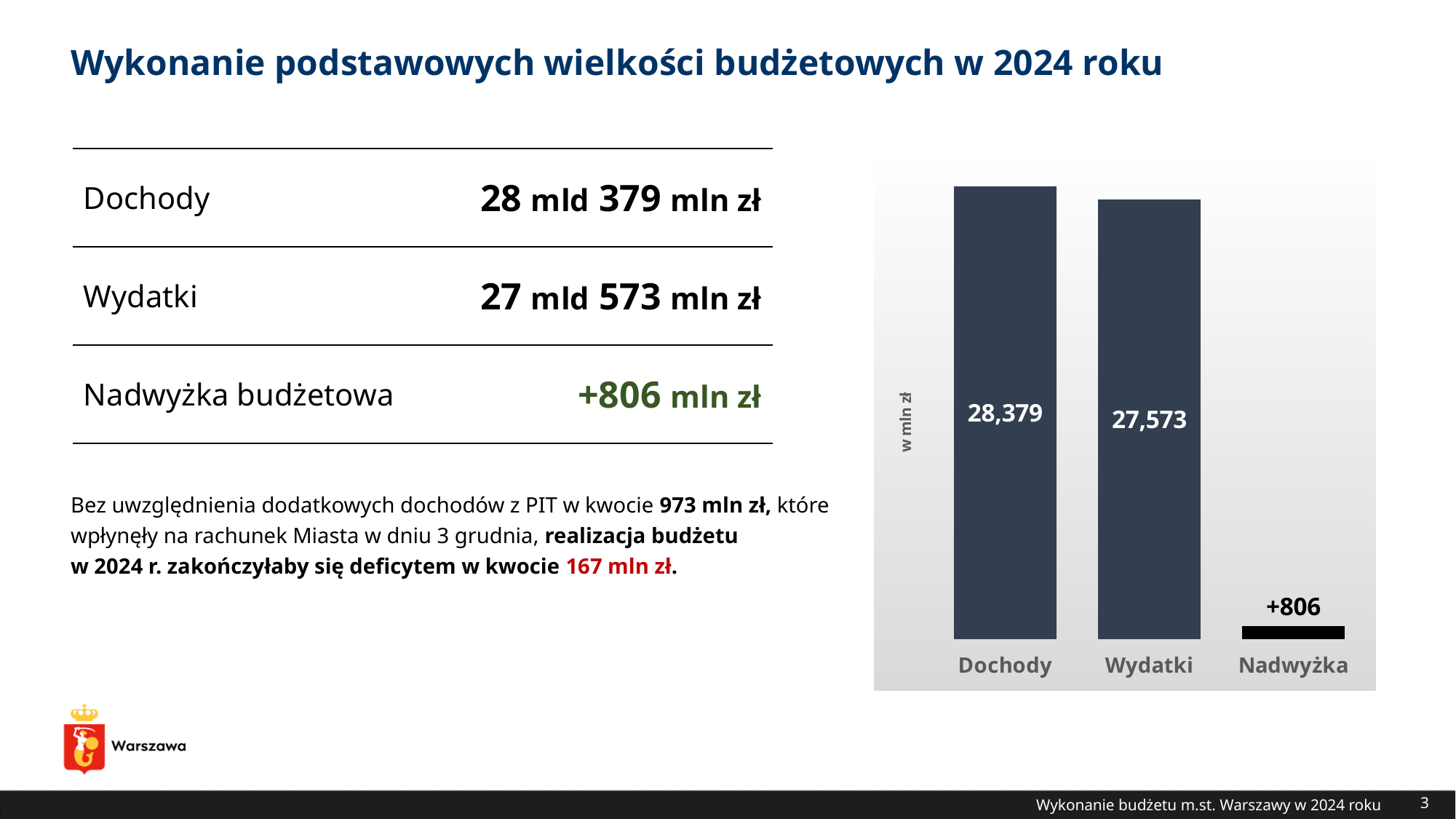
How many categories are shown in the chart? 3 What is the difference between the Dochody and Wydatki values in the chart? 806 What is the value shown for Nadwyżka in the chart? +806 What is the value shown for Dochody in the chart? 28,379 Which category has the highest value in the chart? Dochody Do the values in the chart rise or fall from left to right across the categories? Fall Which category has the lowest value in the chart? Nadwyżka What is the value shown for Wydatki in the chart? 27,573 What kind of chart is shown on the slide? Bar chart Which is larger in the chart, Dochody or Wydatki? Dochody What is the title of the slide containing the chart? Wykonanie podstawowych wielkości budżetowych w 2024 roku What unit is indicated on the vertical axis label of the chart? w mln zł